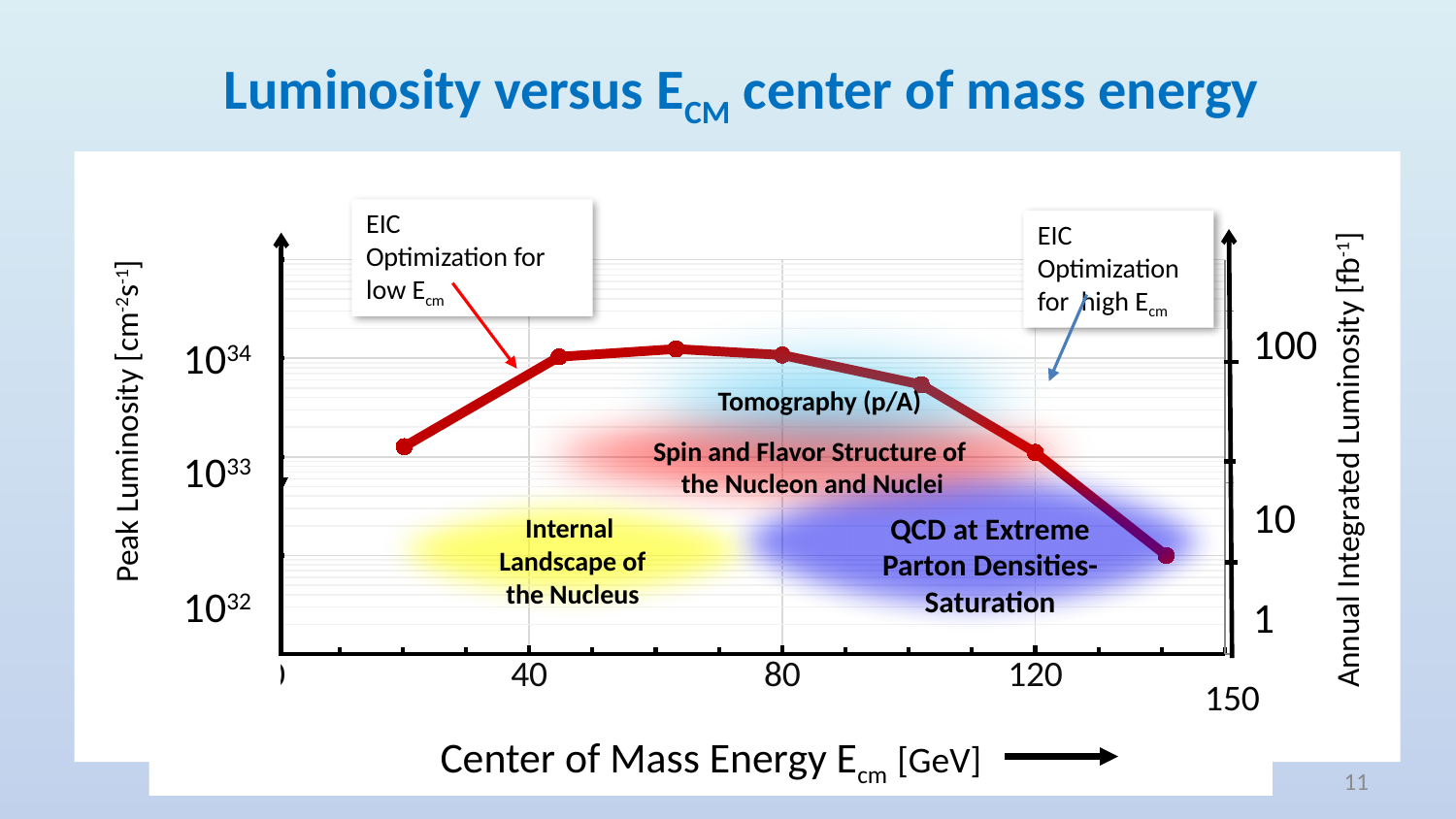
How many data points are plotted on the red line? 7 What kind of chart is shown on the slide? line chart Is the peak luminosity at the rightmost data point greater or less than 10^33 cm^-2 s^-1? less What quantity is plotted on the x axis? Center of Mass Energy Ecm [GeV] What is the title of the slide's chart? Luminosity versus ECM center of mass energy Which has the higher peak luminosity: the leftmost data point or the rightmost data point? the leftmost data point What is the largest tick value shown on the x axis? 150 Does the peak luminosity rise or fall as the center of mass energy increases from 80 GeV to 120 GeV? fall Which has the higher peak luminosity: the point at 80 GeV or the point at 120 GeV? 80 GeV Is the peak luminosity at 120 GeV greater or less than 10^34 cm^-2 s^-1? less Is the peak luminosity at 80 GeV greater or less than 10^33 cm^-2 s^-1? greater